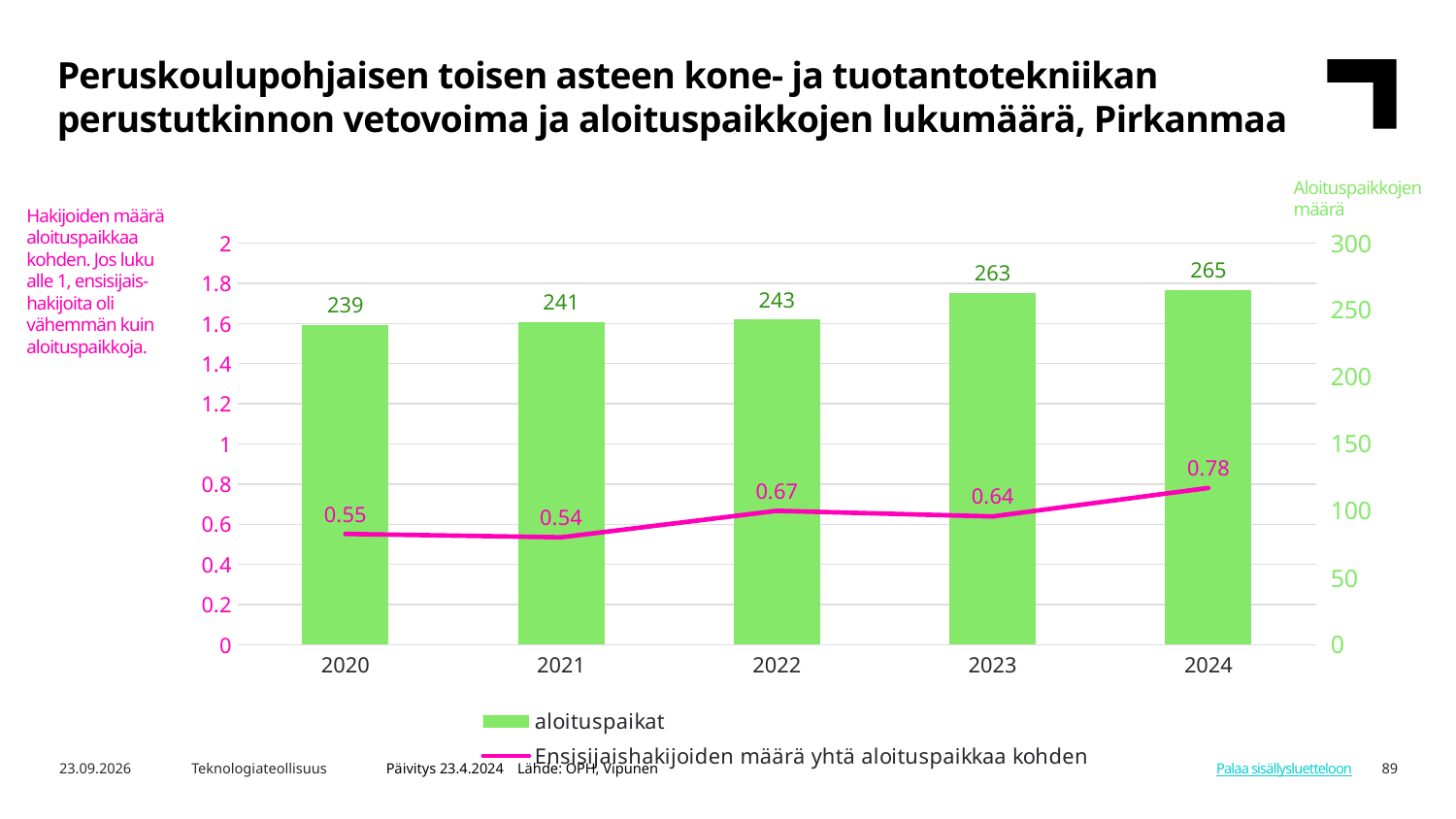
How many series does the legend list? 2 What is the value of Ensisijaishakijoiden määrä yhtä aloituspaikkaa kohden for 2024? 0.78 What is the difference in aloituspaikat between 2023 and 2022? 20 Which year has the lowest value of Ensisijaishakijoiden määrä yhtä aloituspaikkaa kohden? 2021 Which year has the highest value of aloituspaikat? 2024 How many years are shown on the x axis? 5 Does the aloituspaikat series rise or fall from 2020 to 2024? rise What is the value of aloituspaikat for 2022? 243 Is the aloituspaikat value for 2023 greater or less than 250? greater What is the value of aloituspaikat for 2020? 239 What kind of chart is used for the aloituspaikat series? bar chart Which is larger, the Ensisijaishakijoiden määrä yhtä aloituspaikkaa kohden value for 2022 or for 2023? 2022